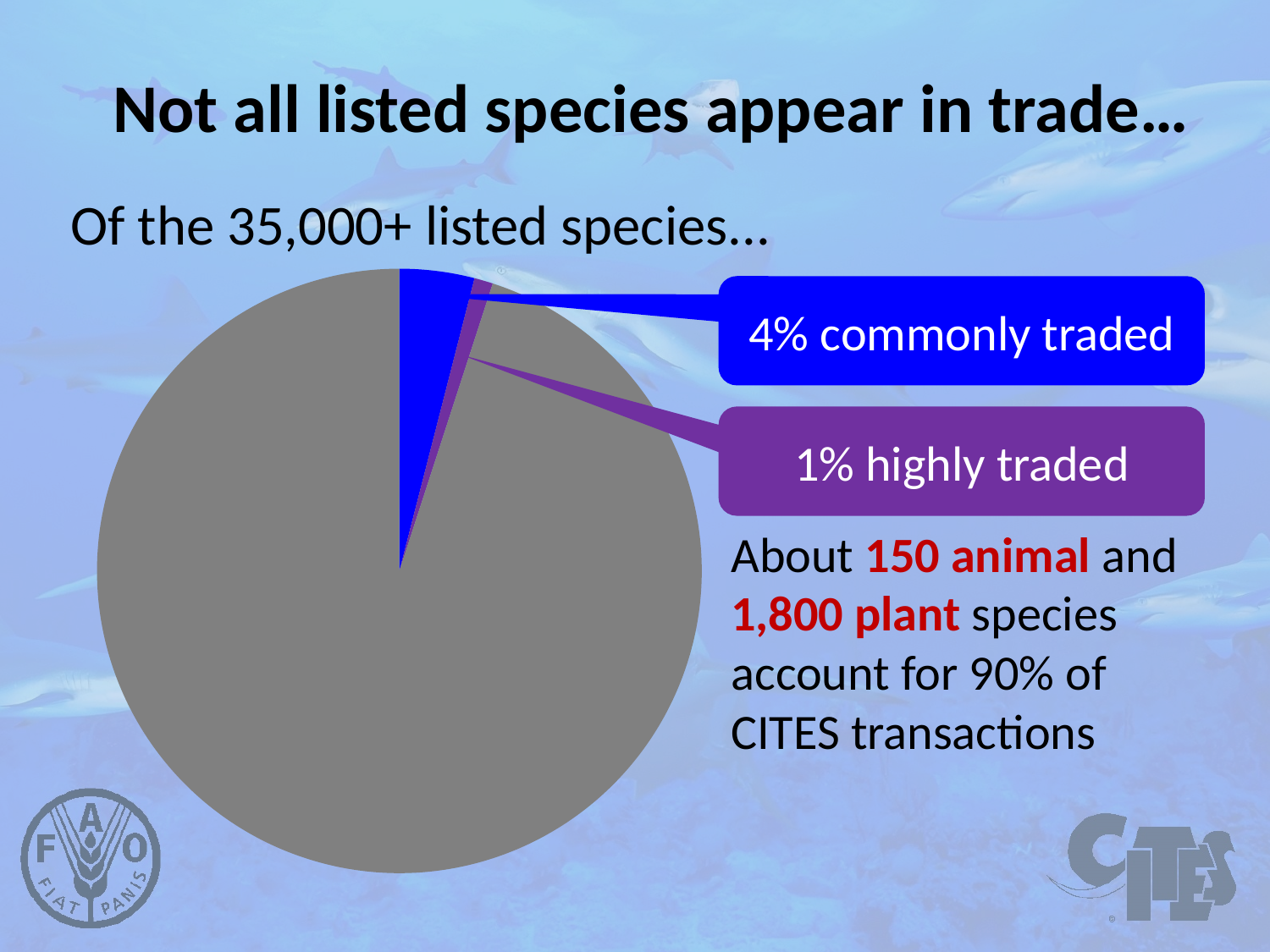
By how many percentage points does the commonly traded share exceed the highly traded share? 3 What is the title of the slide containing the pie chart? Not all listed species appear in trade... What kind of chart is shown on the slide? pie chart What share of listed species is labelled as commonly traded in the pie chart? 4% Which slice of the pie chart is the largest? the grey slice Which labelled slice of the pie chart is the smallest? 1% highly traded What colour is the slice labelled '4% commonly traded'? blue What share of listed species is labelled as highly traded in the pie chart? 1% How many slices does the pie chart have? 3 Which is larger in the pie chart: the commonly traded slice or the highly traded slice? commonly traded